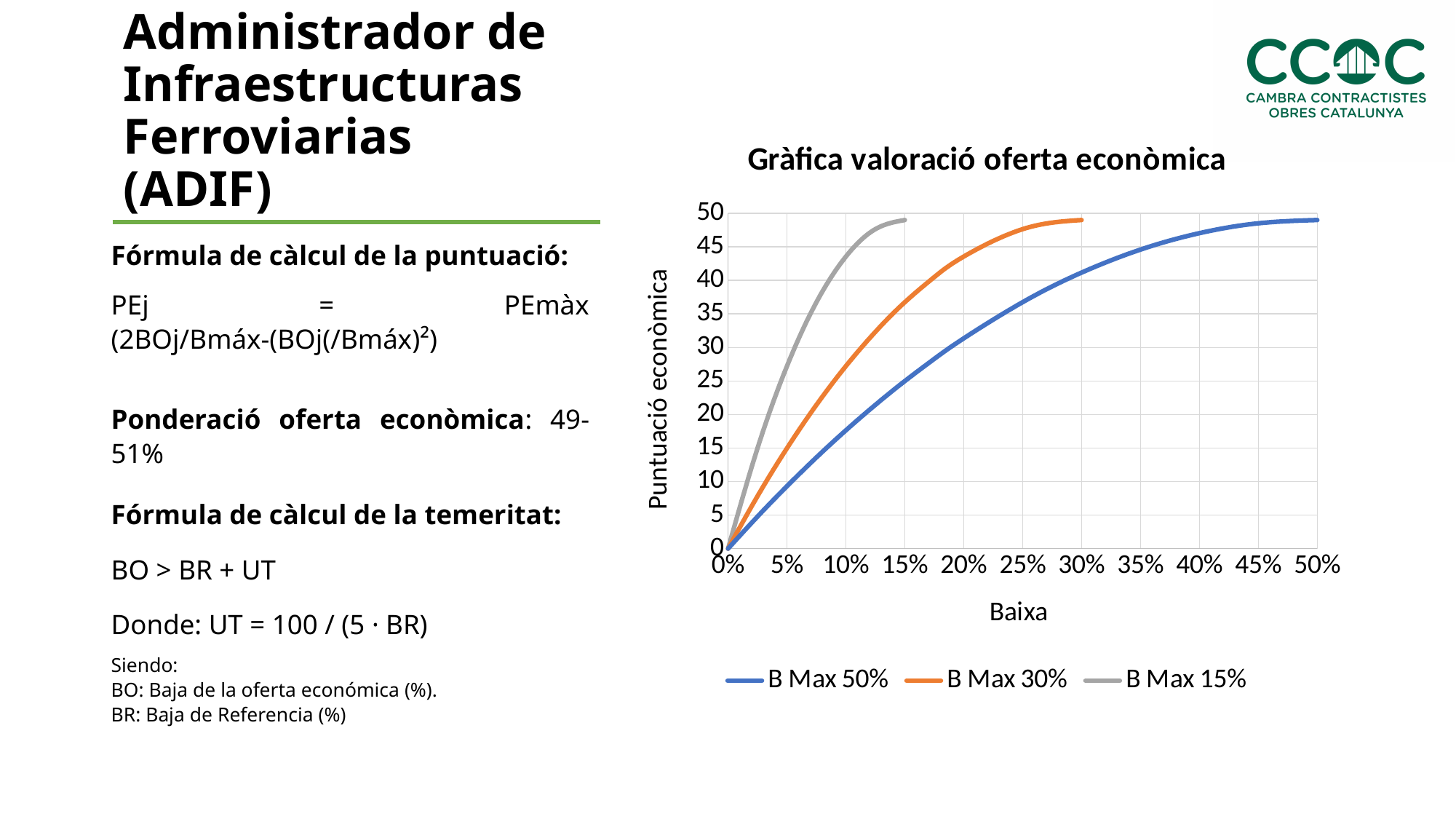
Which series reaches its maximum score at the smallest Baixa value? B Max 15% At what Baixa value does the B Max 30% line end? 30% At a Baixa of 10%, is the value for B Max 30% greater or less than 25? greater Do the values of the B Max 50% series rise or fall as Baixa increases along the x axis? rise At a Baixa of 10%, is the value for B Max 50% greater or less than 20? less At a Baixa of 10%, which series has the higher value, B Max 15% or B Max 50%? B Max 15% How many series does the legend of the chart list? 3 What is the Puntuació econòmica for all three series at a Baixa of 0%? 0 What kind of chart is shown on the slide? line chart At a Baixa of 10%, is the value for B Max 15% greater or less than 40? greater What is the title of the chart? Gràfica valoració oferta econòmica What is the label of the vertical axis of the chart? Puntuació econòmica